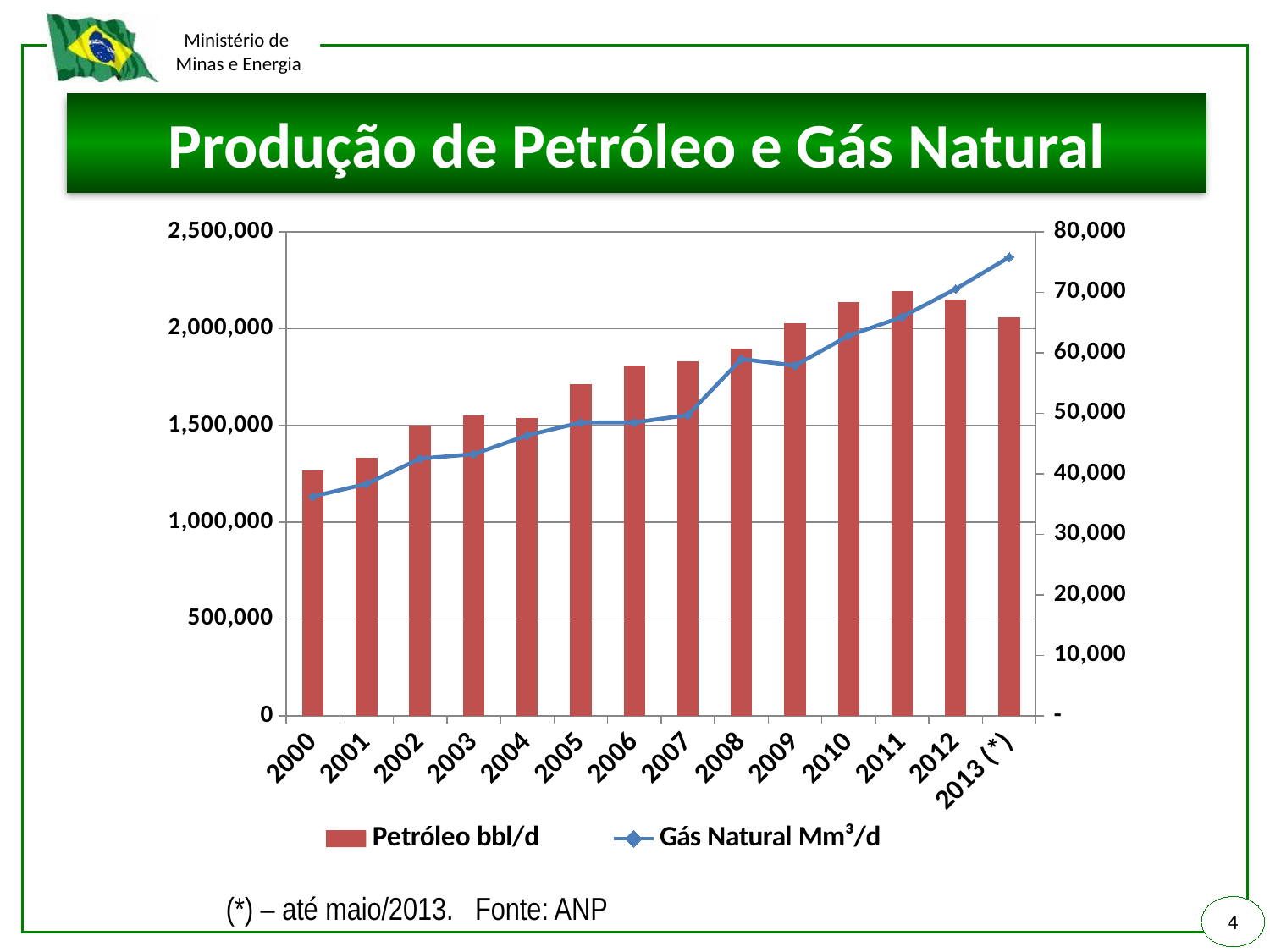
Which year has the highest Gás Natural Mm³/d value? 2013 (*) How many years (categories) are shown on the x axis? 14 Does the Gás Natural Mm³/d line generally rise or fall from 2000 to 2013 (*)? rise Is the Gás Natural Mm³/d value for 2008 greater or less than 50,000? greater Is the Petróleo bbl/d value for 2010 greater or less than 2,000,000? greater Which is larger, the Petróleo bbl/d value for 2012 or for 2013 (*)? 2012 What is the title of the chart? Produção de Petróleo e Gás Natural Is the Petróleo bbl/d value for 2000 greater or less than 1,500,000? less Which year has the lowest Gás Natural Mm³/d value? 2000 Which year has the lowest Petróleo bbl/d value? 2000 What kind of chart is shown on the slide? A combination bar and line chart How many series does the legend list? 2